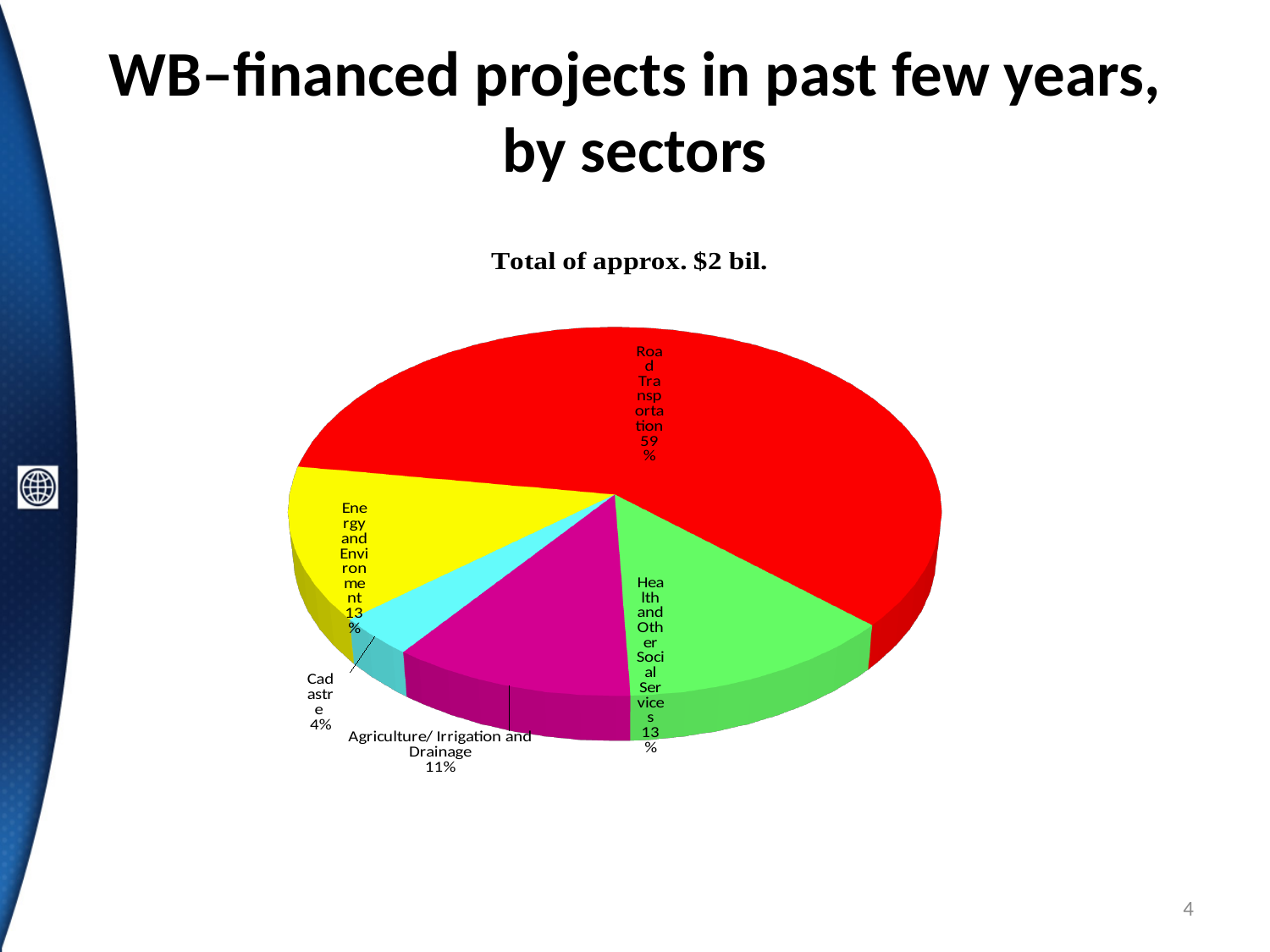
Which sector has the largest slice of the pie? Road Transportation What share of the pie does Energy and Environment have? 13% What is the difference in percentage points between Road Transportation and Agriculture/ Irrigation and Drainage? 48 What share of the pie does Health and Other Social Services have? 13% How many sectors (slices) are shown in the pie chart? 5 What share of the pie does Road Transportation have? 59% Which is larger, the slice for Energy and Environment or the slice for Cadastre? Energy and Environment What kind of chart is shown on the slide? pie chart What share of the pie does Cadastre have? 4% Which sector has the smallest slice of the pie? Cadastre What share of the pie does Agriculture/ Irrigation and Drainage have? 11% What is the chart's title? Total of approx. $2 bil.